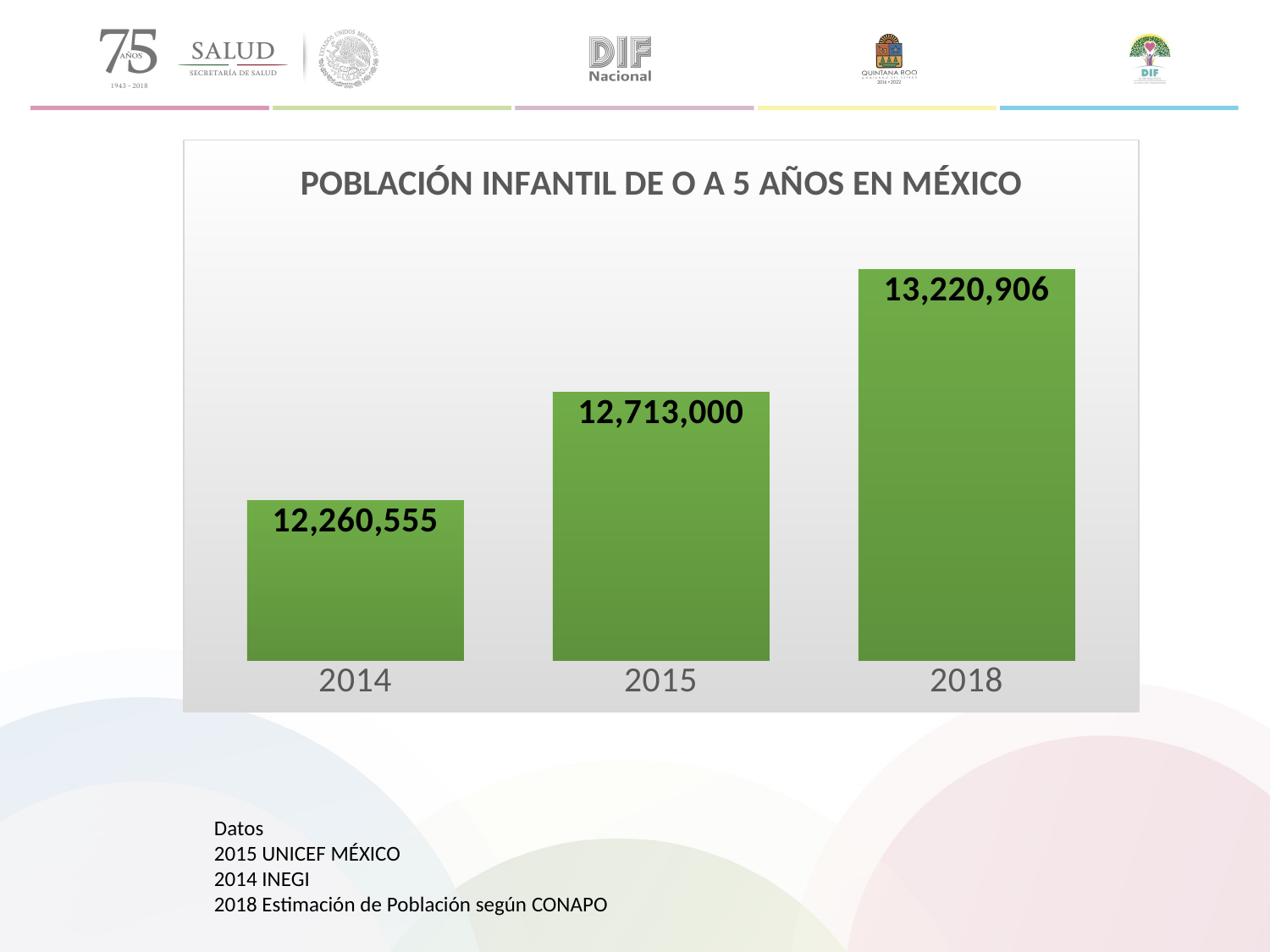
What kind of chart is shown on the slide? Bar chart Which year has the highest value? 2018 What is the difference between the values for 2018 and 2015? 507,906 What is the difference between the values for 2015 and 2014? 452,445 Which is larger, the value for 2015 or the value for 2018? 2018 How many years are shown in the chart? 3 What is the value for 2014? 12,260,555 What is the value for 2018? 13,220,906 What is the value for 2015? 12,713,000 What is the difference between the values for 2018 and 2014? 960,351 Do the values rise or fall from 2014 to 2018? Rise Which year has the lowest value? 2014